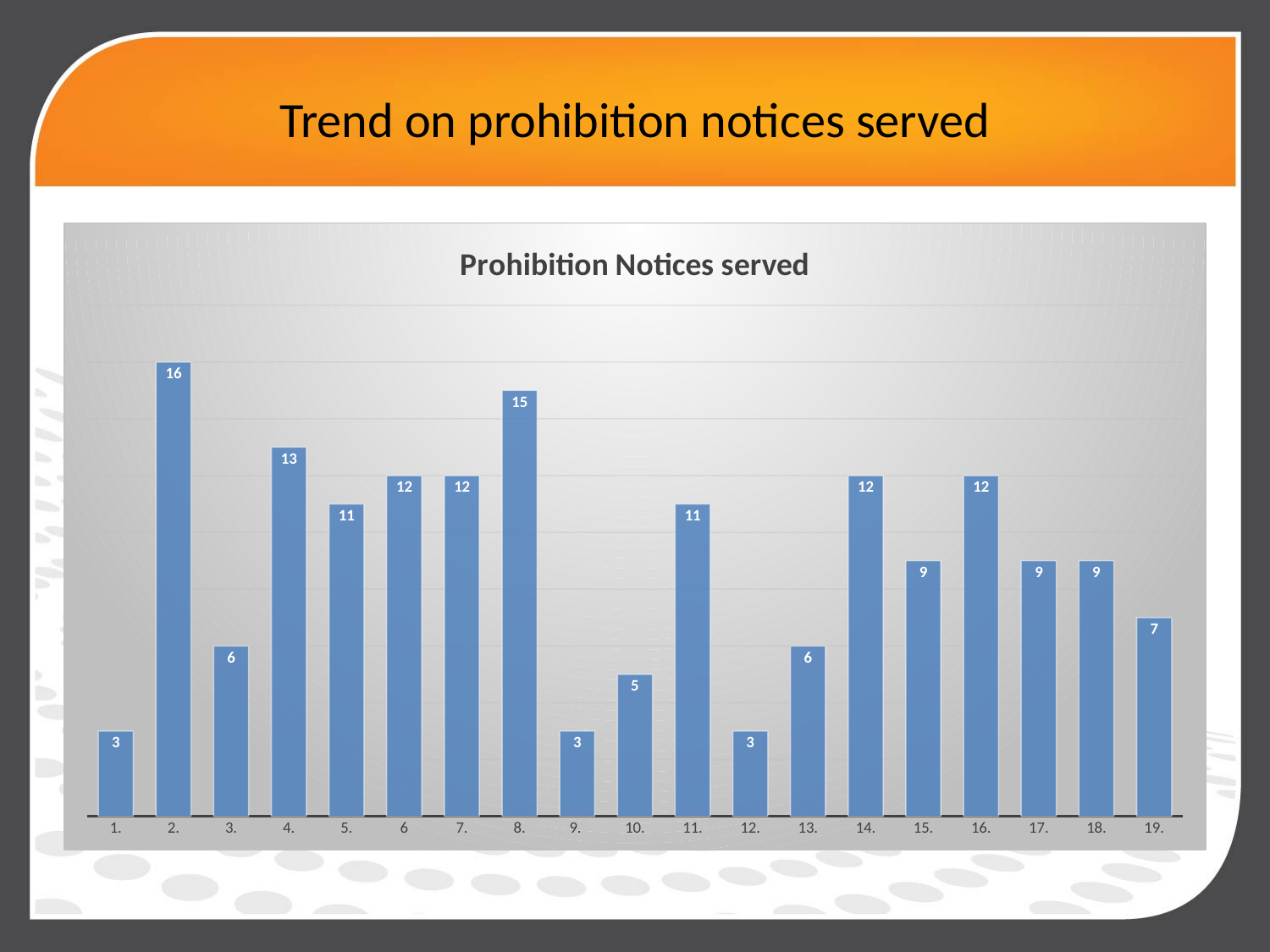
What is the value for category 2 in the Prohibition Notices served chart? 16 How many categories are shown in the Prohibition Notices served chart? 19 What is the difference between the values for category 2 and category 8 in the Prohibition Notices served chart? 1 Which is larger in the Prohibition Notices served chart, the value for category 11 or the value for category 13? category 11 What is the value for category 8 in the Prohibition Notices served chart? 15 What is the title of the chart on the slide? Prohibition Notices served What is the value for category 19 in the Prohibition Notices served chart? 7 What is the difference between the values for category 4 and category 3 in the Prohibition Notices served chart? 7 What kind of chart is the Prohibition Notices served chart? bar chart What is the value for category 10 in the Prohibition Notices served chart? 5 What is the lowest value shown in the Prohibition Notices served chart? 3 Which category has the highest value in the Prohibition Notices served chart? 2